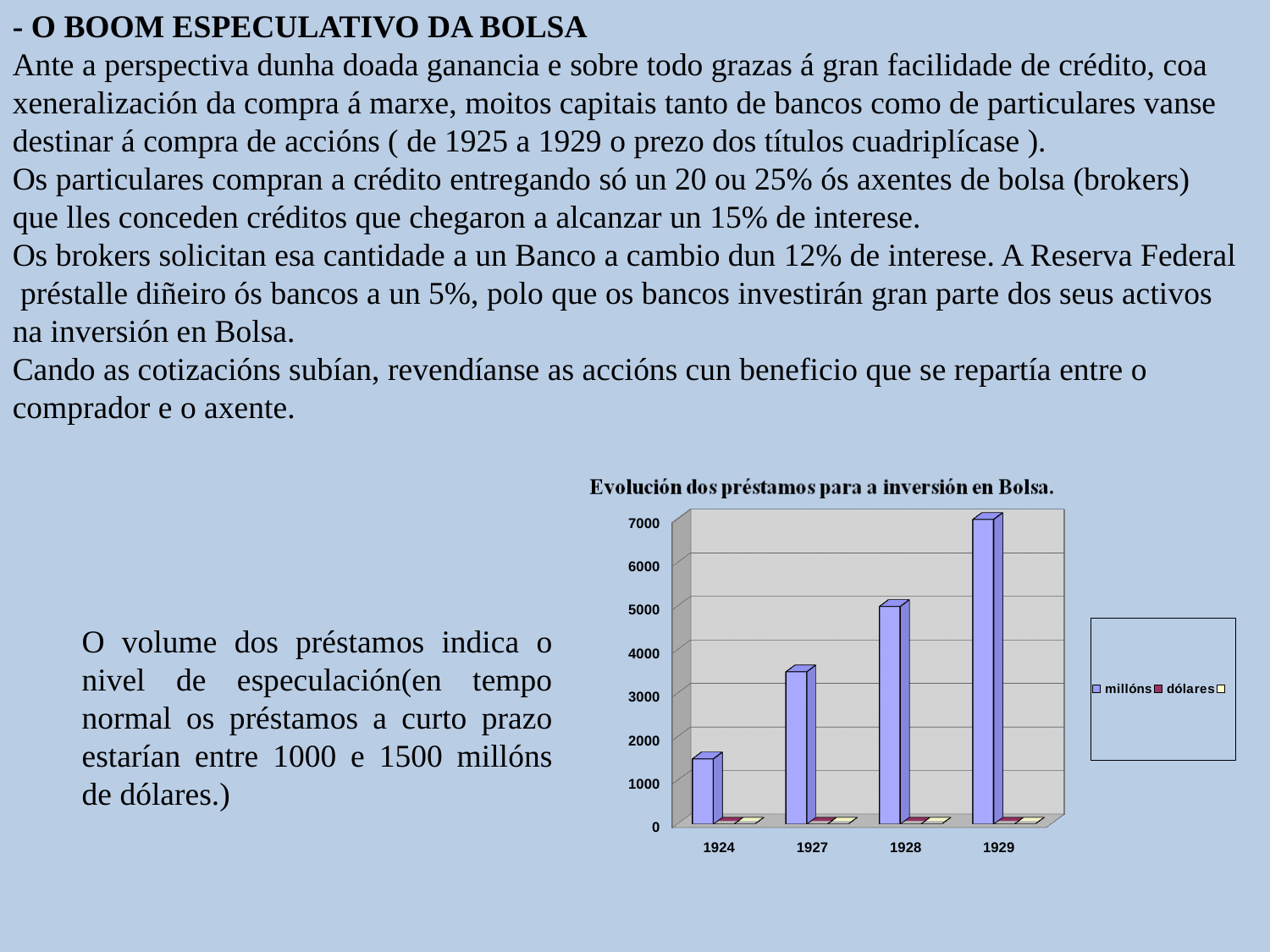
What is the title of the chart? Evolución dos préstamos para a inversión en Bolsa. Which year has the larger value, 1927 or 1928? 1928 Is the value for 1927 greater or less than 3000? greater How many years are shown on the x axis of the chart? 4 Which year has the lowest bar in the chart? 1924 Do the values rise or fall from 1924 to 1929? rise Is the value for 1927 greater or less than 4000? less Is the value for 1924 greater or less than 1000? greater Which year has the highest bar in the chart? 1929 What kind of chart is shown on the slide? bar chart What is the highest value labelled on the vertical axis of the chart? 7000